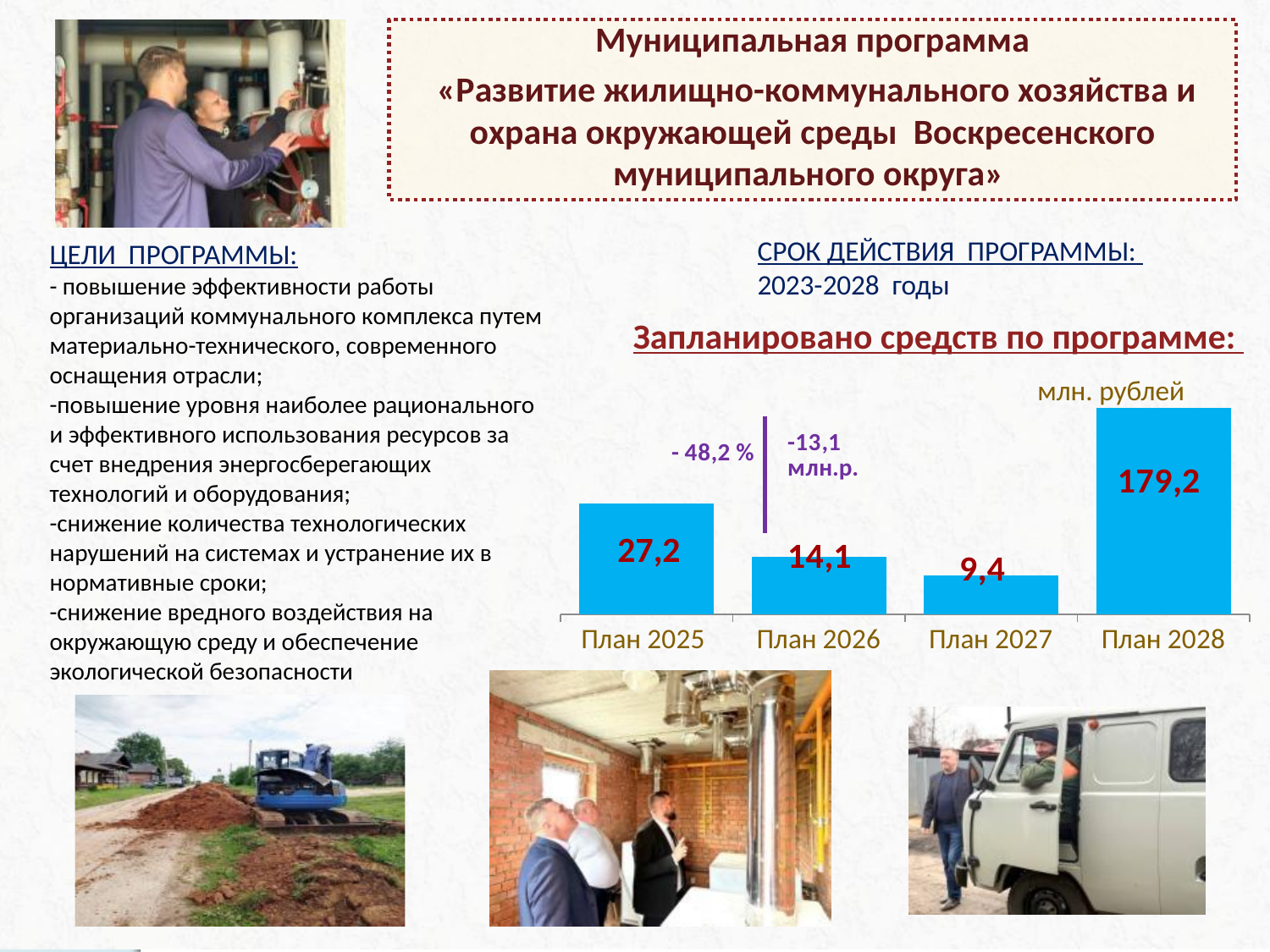
In what units are the chart values given? млн. рублей What is the planned amount for План 2028? 179,2 What kind of chart is shown on the slide? Bar chart Which year has the lowest planned amount? План 2027 Which is larger, the planned amount for План 2026 or План 2027? План 2026 What is the planned amount for План 2027? 9,4 What is the difference between the planned amounts for План 2025 and План 2026? 13,1 What is the planned amount for План 2025? 27,2 How many categories are shown on the chart? 4 Which year has the highest planned amount? План 2028 What percentage change is annotated between План 2025 and План 2026? - 48,2 % What is the planned amount for План 2026? 14,1